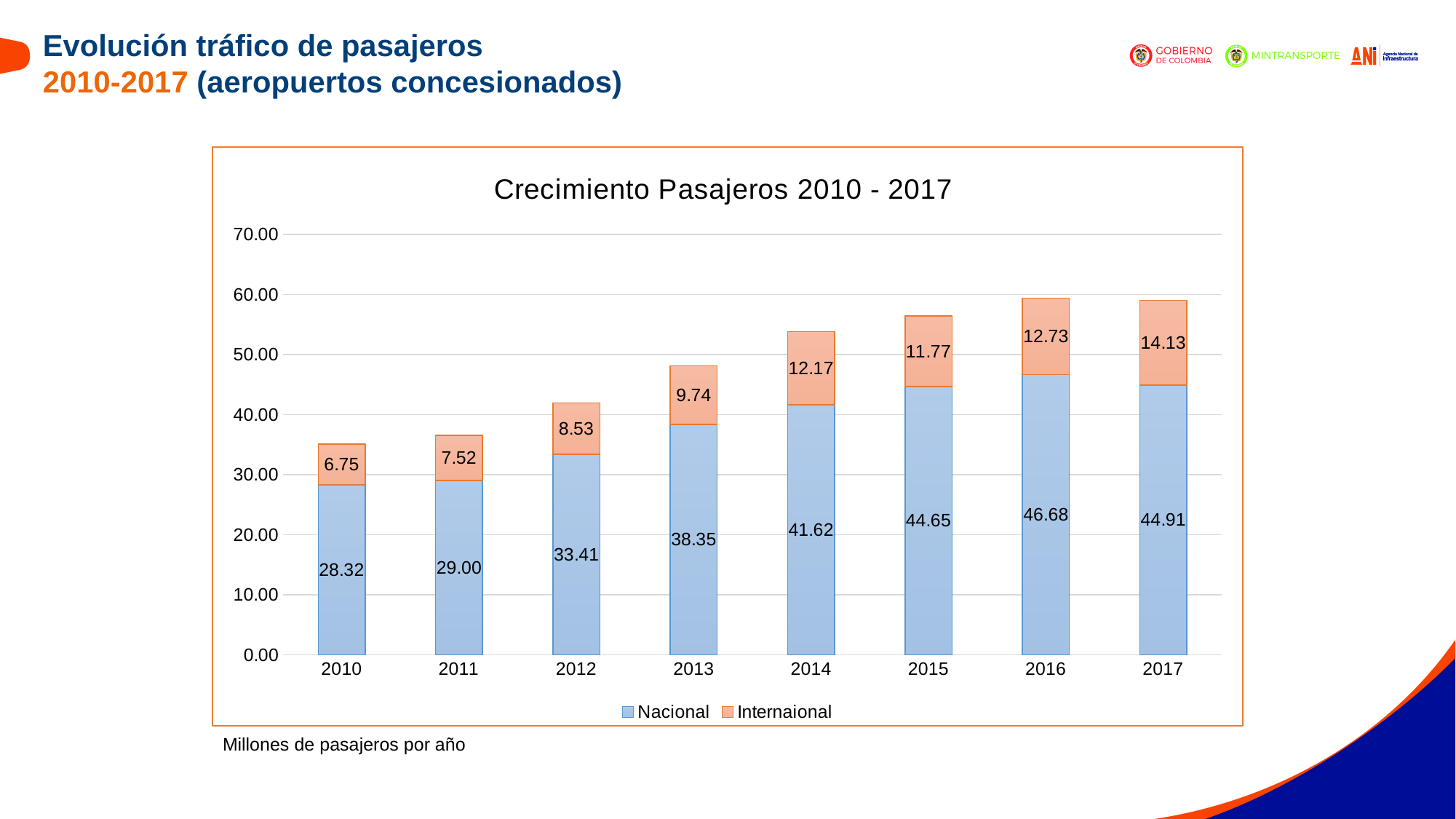
What is the difference between the Internaional values for 2017 and 2016? 1.40 What kind of chart is shown? Stacked bar chart Is the total stacked bar for 2013 greater or less than 40.00? greater Which is larger, the Nacional value for 2015 or the Nacional value for 2017? 2017 How many years are shown on the x axis? 8 How many series does the legend list? 2 What is the total of the stacked bar for 2010? 35.07 What is the title of the chart? Crecimiento Pasajeros 2010 - 2017 What is the Nacional value for 2014? 41.62 What is the Internaional value for 2012? 8.53 Which year has the highest Nacional value? 2016 Which year has the lowest Internaional value? 2010